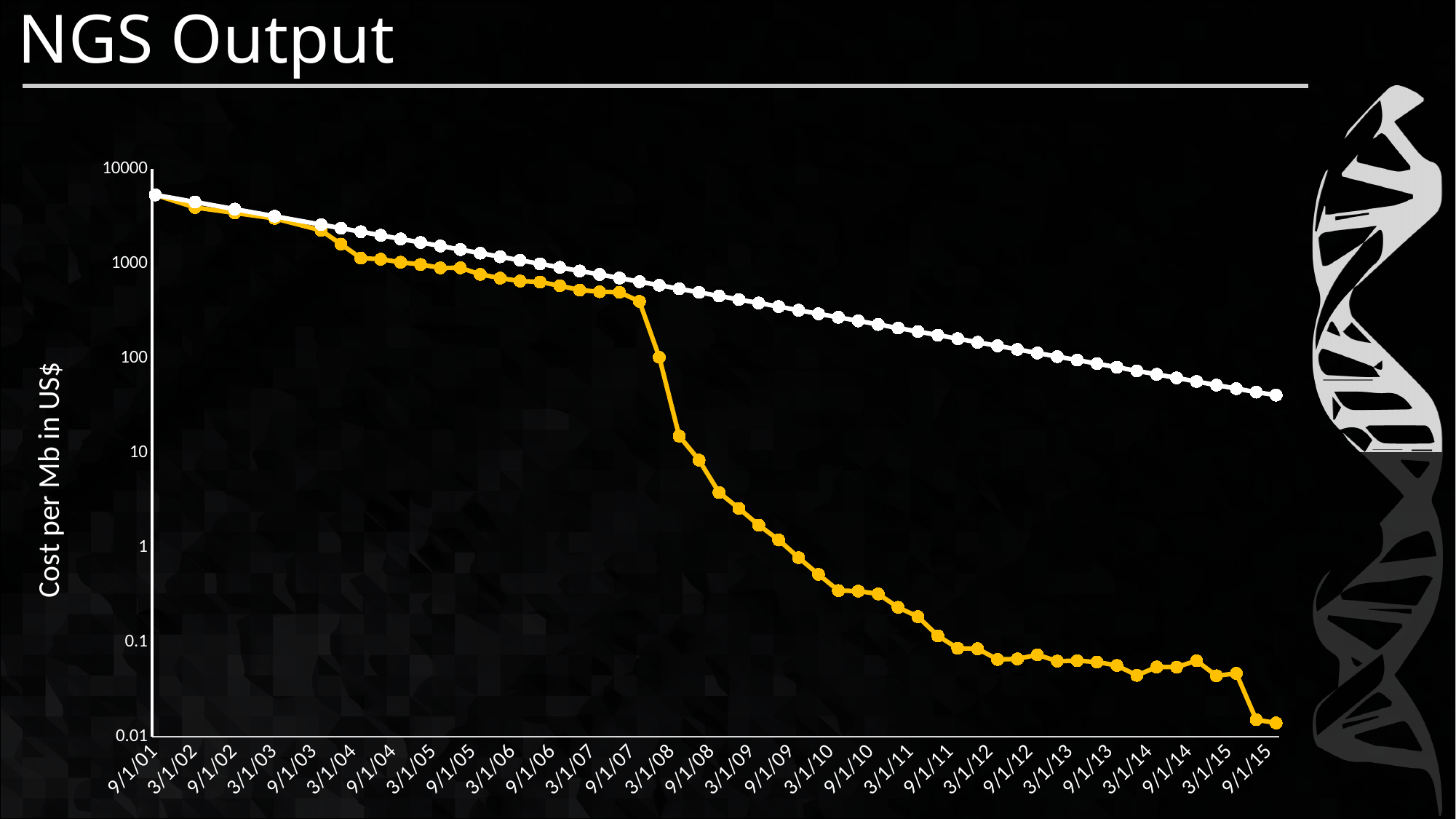
Is the value of the yellow line at 9/1/01 greater or less than 1000? greater Do the values of the yellow line rise or fall from 9/1/01 to 9/1/15? fall What is the title of the slide containing the chart? NGS Output Do the values of the white line rise or fall along the x axis? fall Is the value of the yellow line at 9/1/15 greater or less than 0.1? less What kind of chart is shown on the slide? line chart Is the value of the white line at 9/1/15 greater or less than 10? greater How many lines are plotted on the chart? 2 At 9/1/15, which line has the higher value, the white line or the yellow line? the white line What is the label on the vertical axis of the chart? Cost per Mb in US$